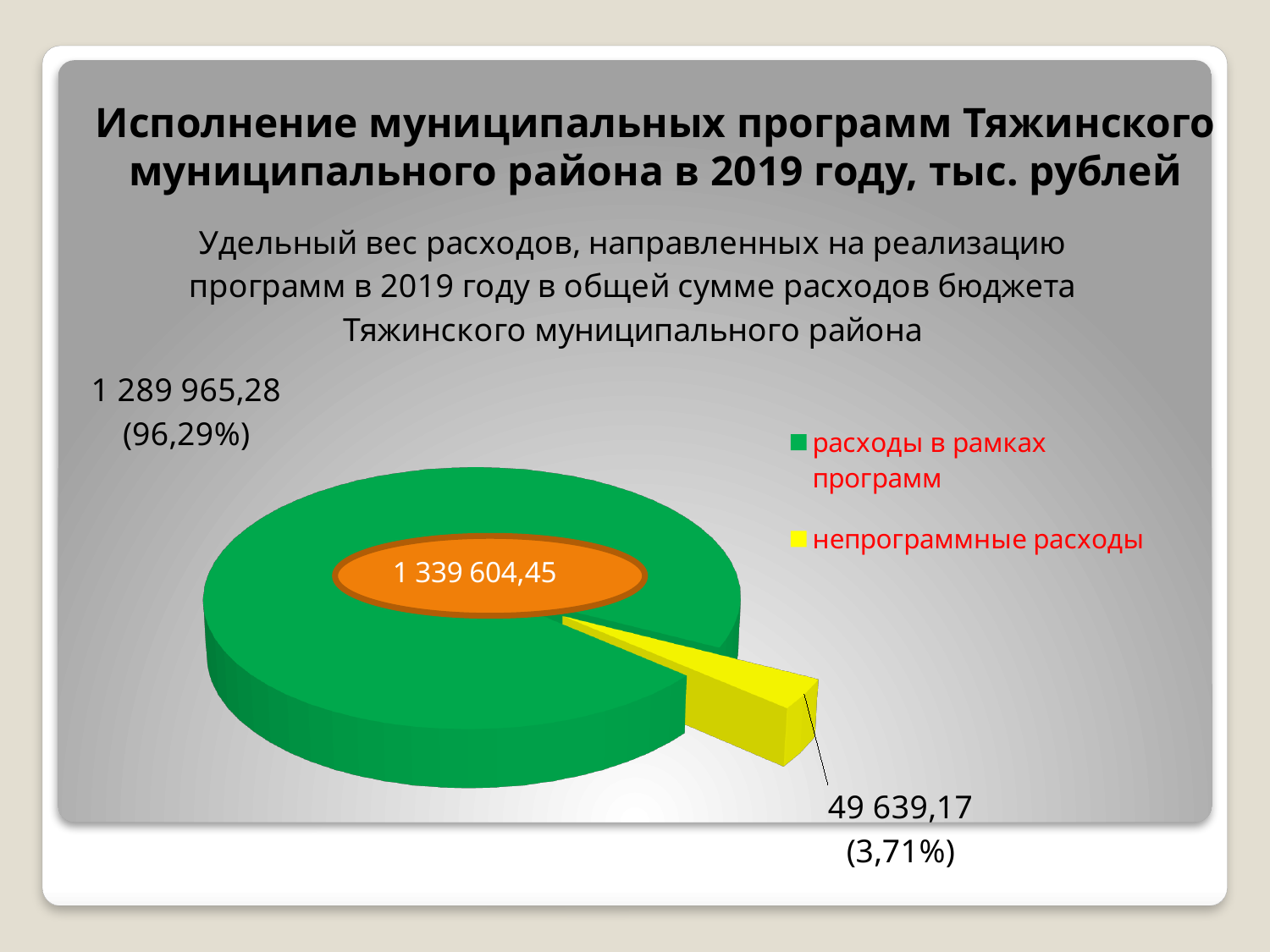
What share of the pie does "расходы в рамках программ" represent? 96,29% Which slice is the smallest? непрограммные расходы What total value is printed in the centre of the pie chart? 1 339 604,45 What colour is the slice for "непрограммные расходы"? yellow Which is larger, "расходы в рамках программ" or "непрограммные расходы"? расходы в рамках программ How many slices does the pie chart have? 2 What is the value for "непрограммные расходы"? 49 639,17 What is the value for "расходы в рамках программ"? 1 289 965,28 How many entries does the legend list? 2 What kind of chart is shown on the slide? pie chart Which slice is the largest? расходы в рамках программ What share of the pie does "непрограммные расходы" represent? 3,71%